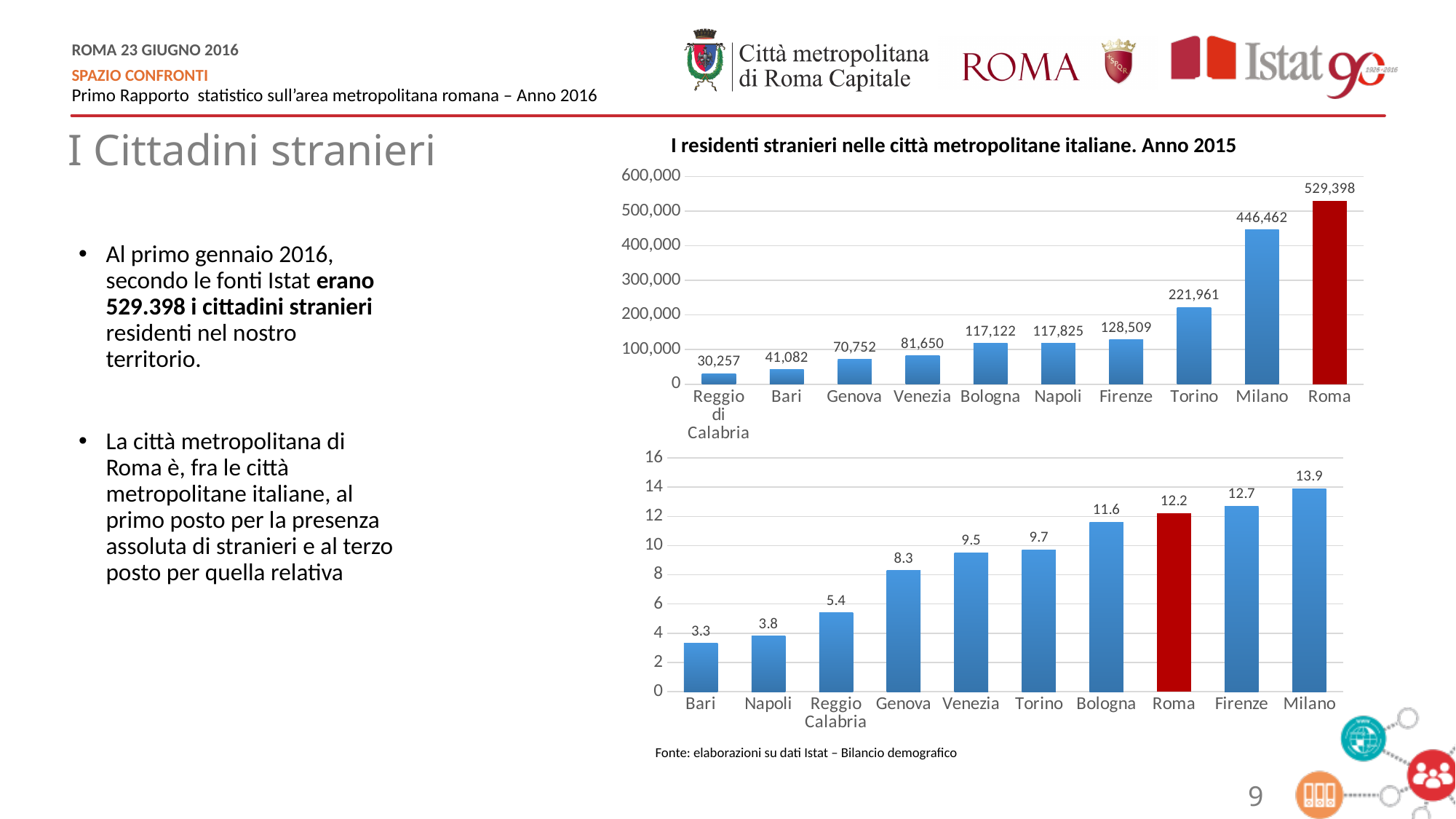
What is the title of the top chart? I residenti stranieri nelle città metropolitane italiane. Anno 2015 In the bottom chart, what is the value for Roma? 12.2 In the bottom chart, which city has the highest value? Milano In the top chart, which city has the lowest value? Reggio di Calabria What kind of chart is the bottom chart? bar chart In the bottom chart, do the values rise or fall from left to right along the x axis? rise In the bottom chart, what is the difference between the values for Milano and Bari? 10.6 In the top chart, what is the value for Torino? 221,961 In the bottom chart, which city has the lowest value? Bari In the top chart, how many cities are shown? 10 In the top chart, what is the value for Roma? 529,398 In the top chart, what is the difference between the values for Roma and Milano? 82,936